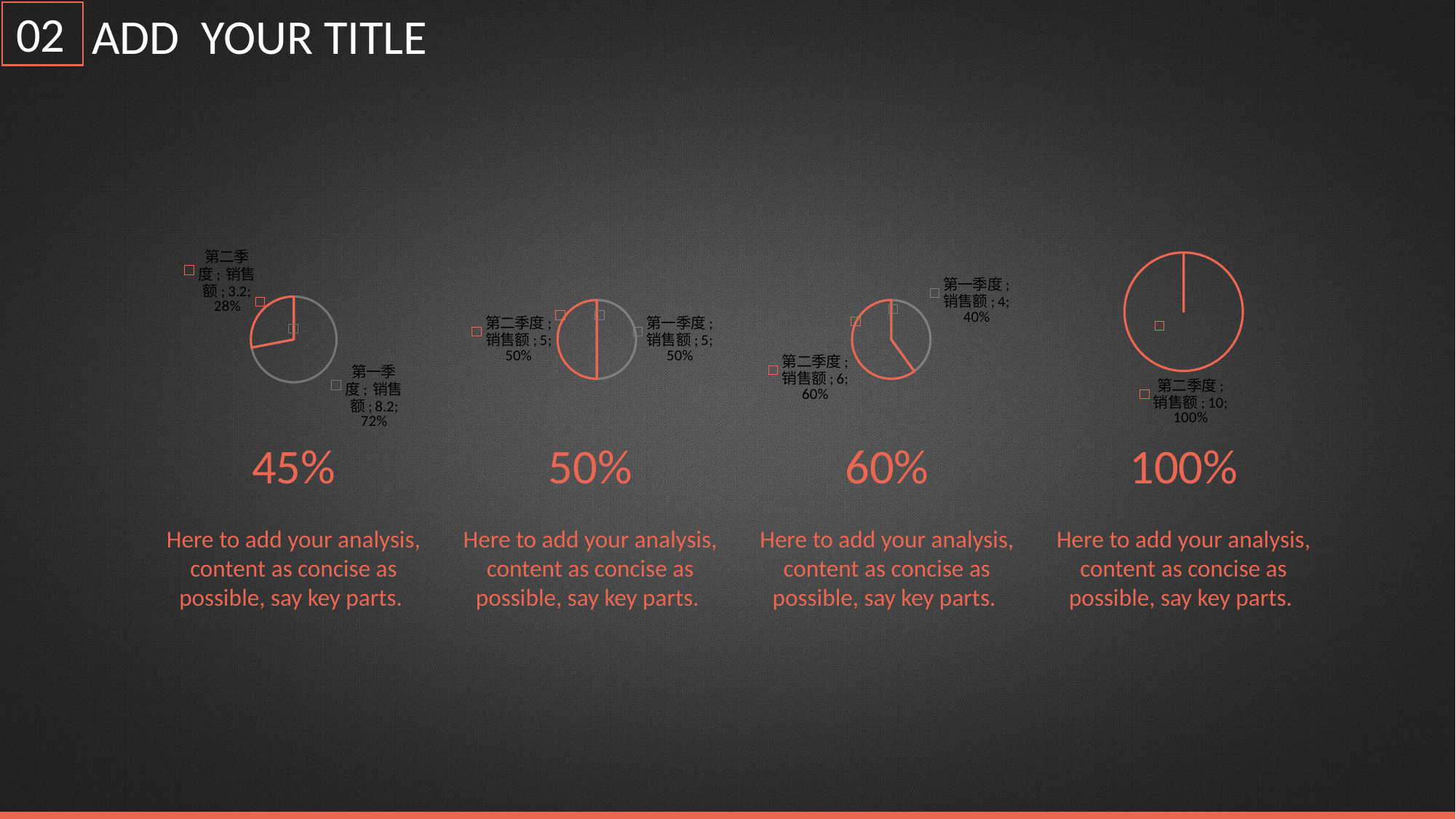
What type of chart is the leftmost chart on the slide? Pie chart In the leftmost pie chart, what is the sales value (销售额) for 第二季度? 3.2 In the second pie chart from the left, what is the sales value for 第一季度? 5 In the rightmost pie chart, what is the sales value for 第二季度? 10 In the third pie chart from the left, which quarter has the smallest slice? 第一季度 In the third pie chart from the left, what percentage share does 第一季度 have? 40% In the leftmost pie chart, what percentage share does 第一季度 have? 72% In the third pie chart from the left, what is the sales value for 第二季度? 6 In the second pie chart from the left, what percentage share does 第二季度 have? 50% In the leftmost pie chart, what is the difference between the 第一季度 and 第二季度 sales values? 5.0 How many pie charts are shown on the slide? 4 In the leftmost pie chart, which quarter has the larger slice, 第一季度 or 第二季度? 第一季度